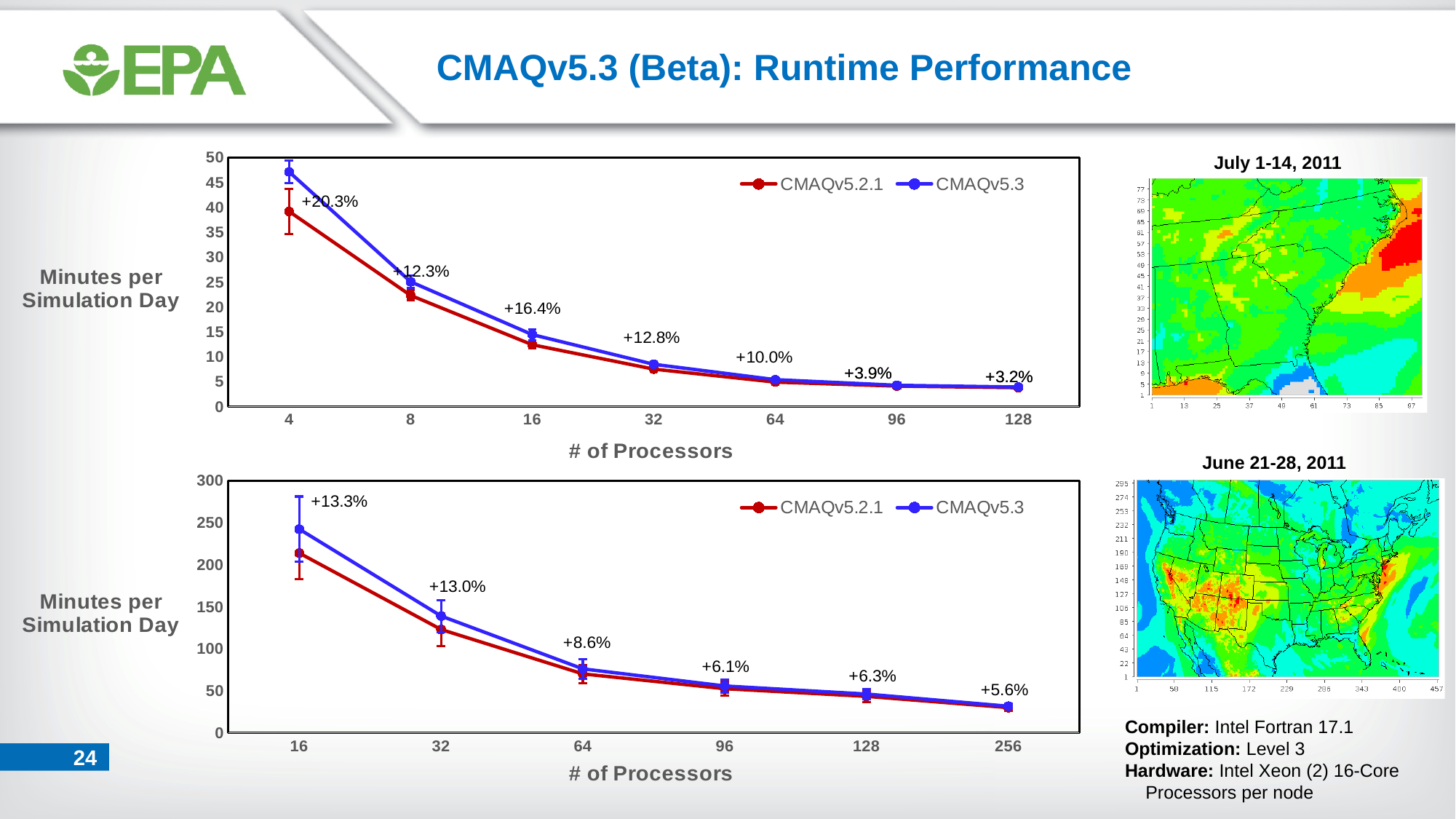
In the bottom chart, how many processor counts are plotted along the x axis? 6 In the top chart, how many processor counts are plotted along the x axis? 7 In the top chart, at which processor count is the labelled percentage difference the smallest? 128 In the top chart, is the CMAQv5.3 value at 4 processors greater or less than 40? greater In the bottom chart, what percentage difference is labelled at 64 processors? +8.6% In the bottom chart, at which processor count is the labelled percentage difference the largest? 16 How many series does the legend of the top chart list? 2 In the bottom chart, is the CMAQv5.2.1 value at 16 processors greater or less than 200? greater In the top chart, what percentage difference is labelled at 4 processors? +20.3% In the bottom chart, do the minutes per simulation day rise or fall as the number of processors increases? fall What kind of chart is the top chart (Minutes per Simulation Day vs # of Processors, 4 to 128)? line chart In the top chart, what percentage difference is labelled at 128 processors? +3.2%